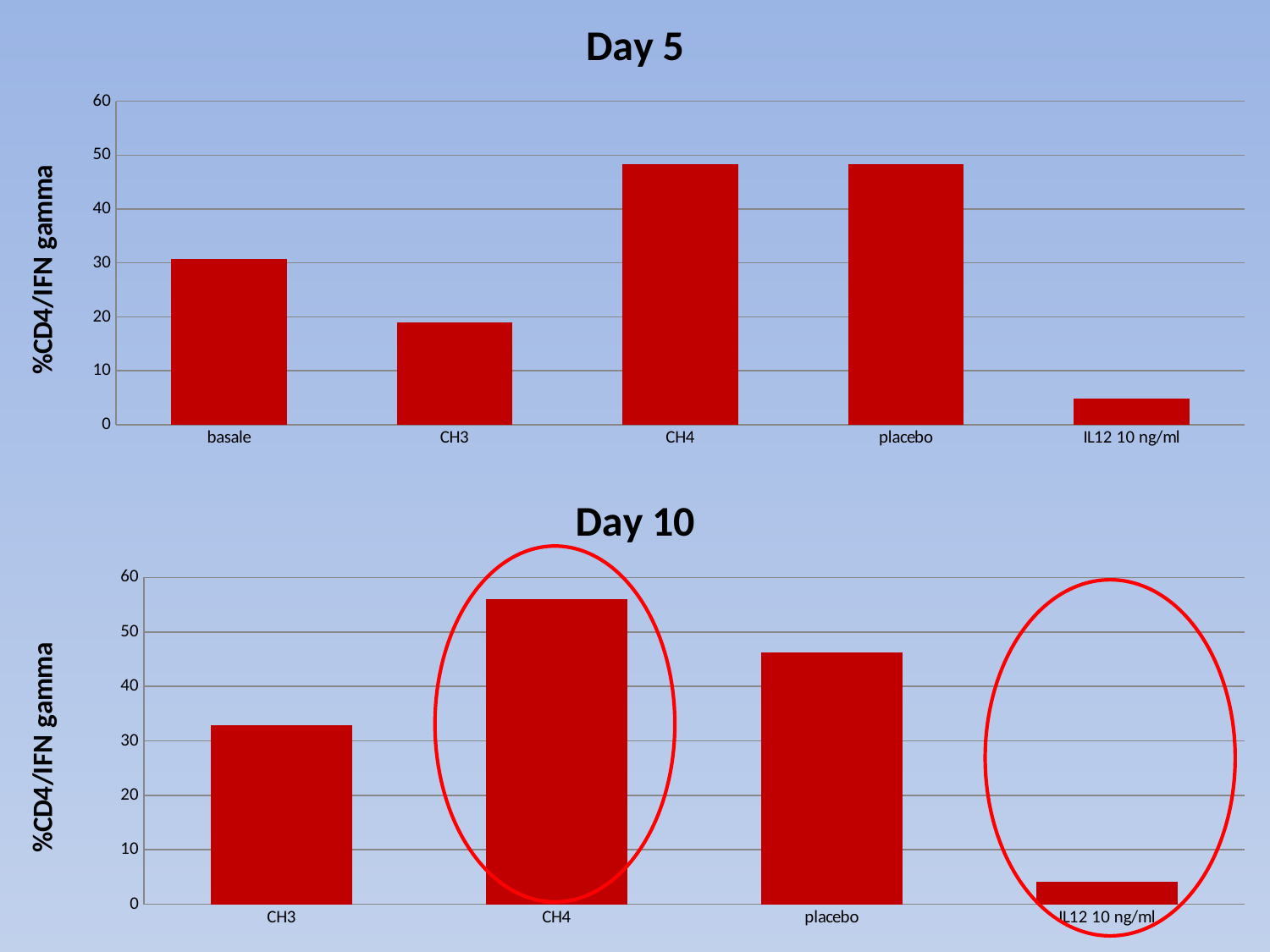
On the Day 10 chart, which category has the highest value? CH4 What kind of chart is the Day 5 chart? bar chart On the Day 10 chart, is the value for CH4 greater or less than 50? greater On the Day 10 chart, which category has the lowest value? IL12 10 ng/ml How many categories are shown on the Day 5 chart? 5 On the Day 10 chart, is the value for placebo greater or less than 50? less On the Day 5 chart, is the value for CH4 greater or less than 40? greater How many categories are shown on the Day 10 chart? 4 On the Day 5 chart, which category has the lowest value? IL12 10 ng/ml On the Day 5 chart, which is larger, the value for basale or the value for CH3? basale What is the y-axis label on the Day 10 chart? %CD4/IFN gamma